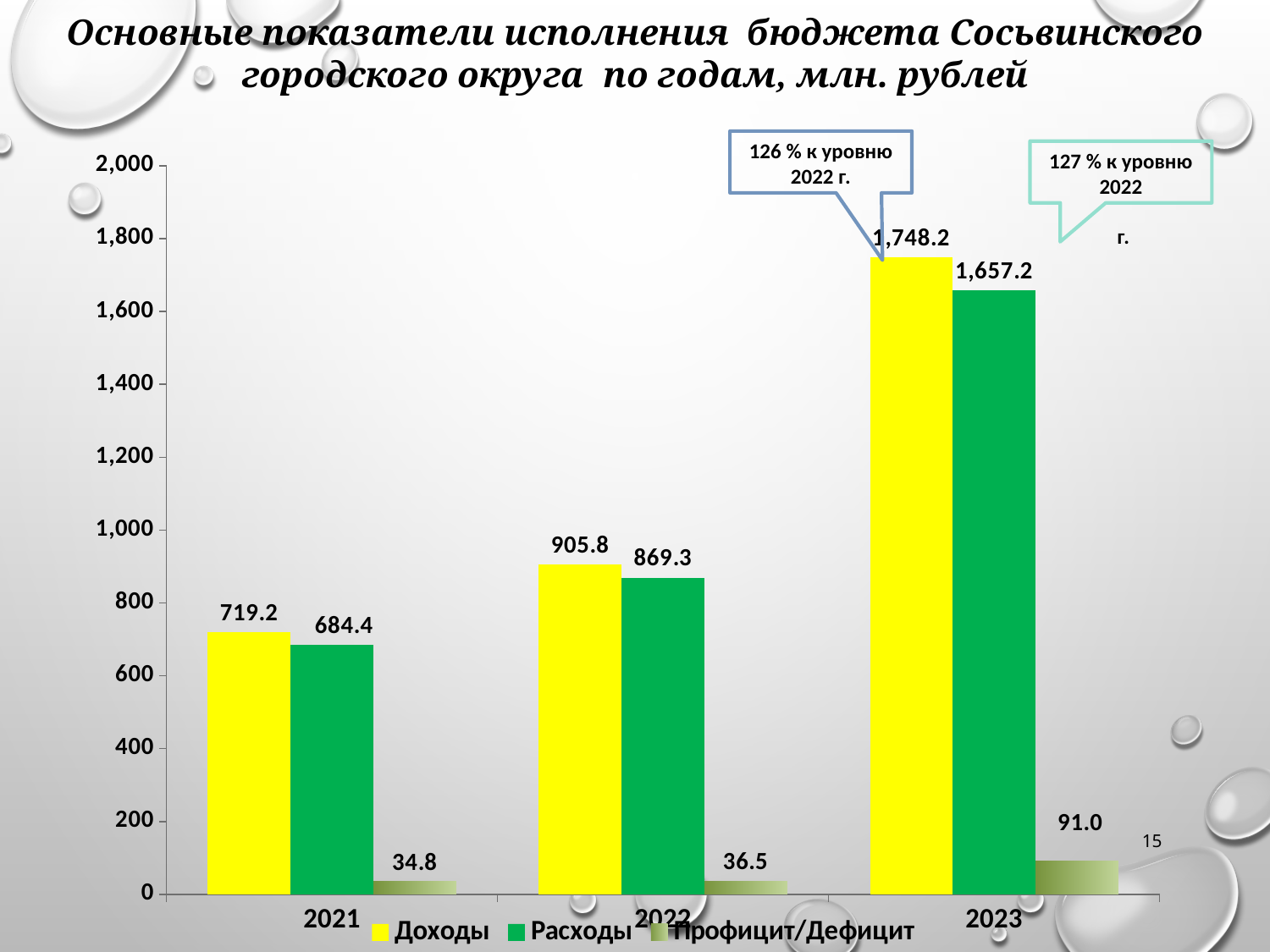
What is the value of Профицит/Дефицит for 2022? 36.5 In which year is Доходы the lowest? 2021 What kind of chart is shown on the slide? bar chart Is the value of Расходы for 2022 greater or less than 1,000? less What is the value of Доходы for 2023? 1,748.2 Do the values of Доходы rise or fall from 2021 to 2023? rise Which is larger in 2023, Доходы or Расходы? Доходы What is the difference between Доходы and Расходы in 2022? 36.5 How many series does the legend list? 3 What is the value of Расходы for 2021? 684.4 In which year is Расходы the highest? 2023 How many years are shown on the x axis? 3